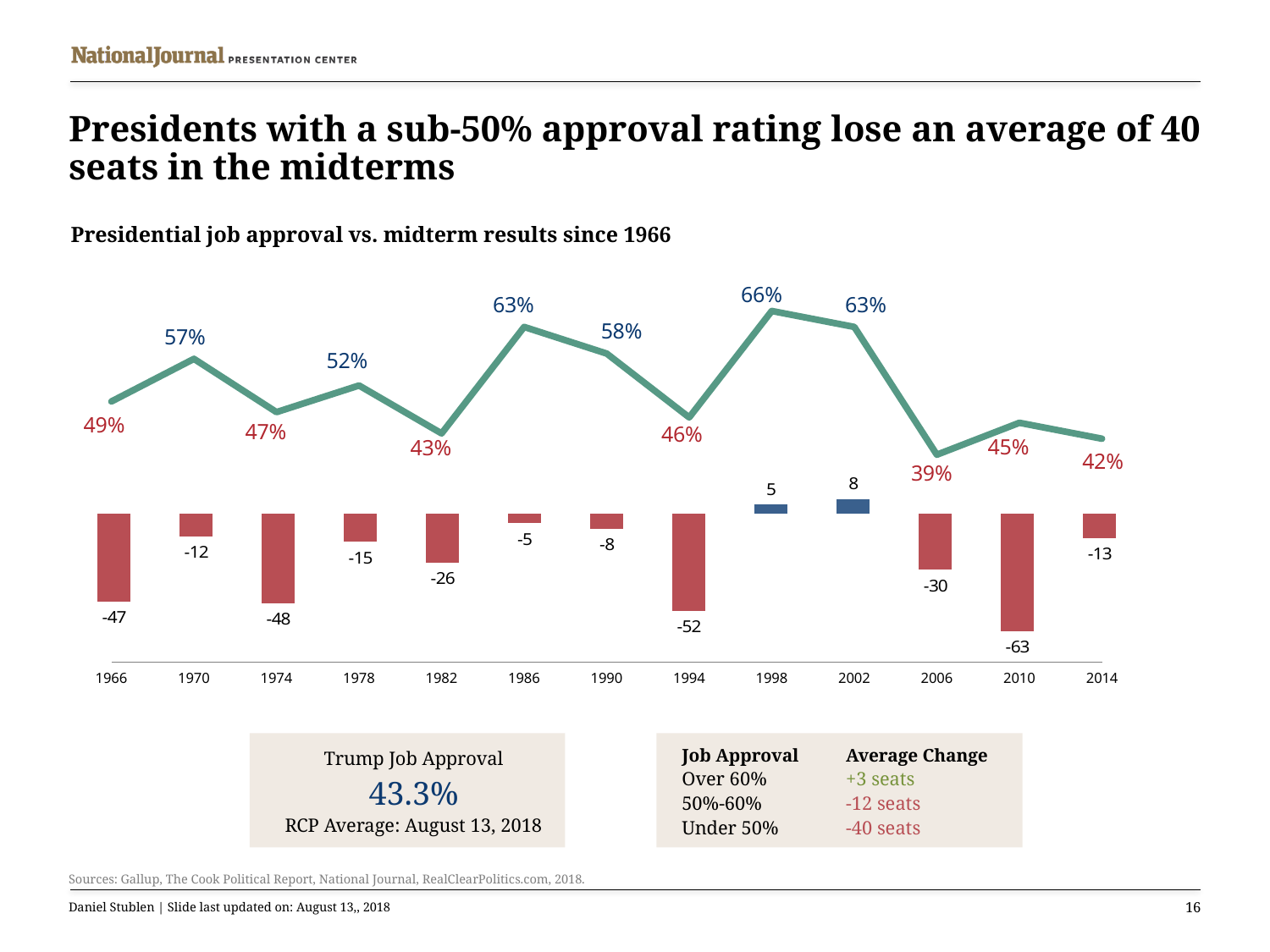
Which year had a higher approval rating, 1970 or 1978? 1970 How many midterm years show a gain in seats? 2 What was the midterm seat change in 2002? 8 How many midterm years are plotted on the chart? 13 In which year was the presidential job approval rating lowest? 2006 What was the presidential job approval rating in 2006? 39% What kinds of chart are combined on the slide? A line chart and a bar chart What was the presidential job approval rating in 1998? 66% In which year was the largest loss of seats in the midterms? 2010 What is the difference between the approval ratings in 1986 and 1982? 20 percentage points In which year was the presidential job approval rating highest? 1998 What was the midterm seat change in 2010? -63